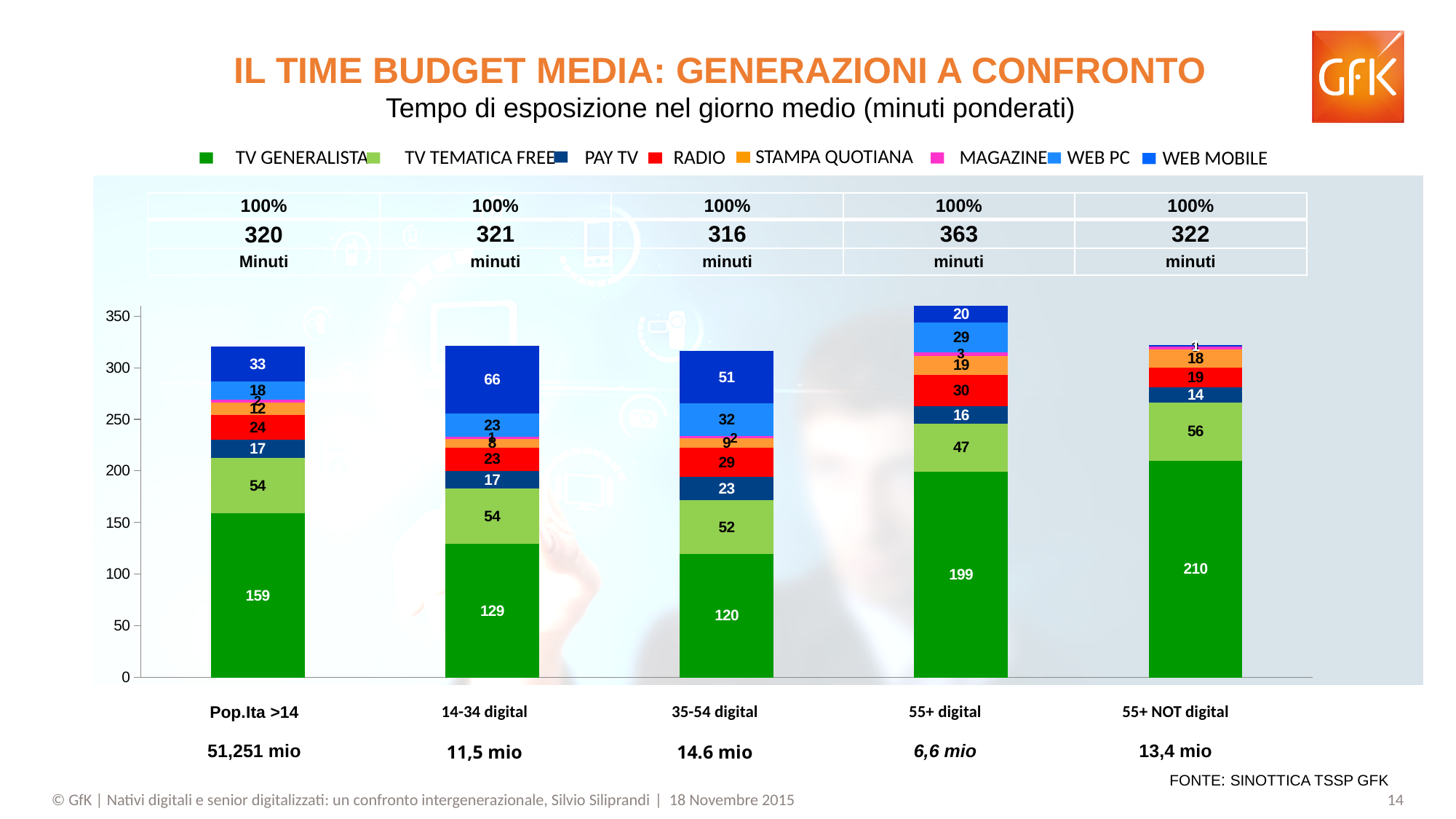
What is the difference between the TV GENERALISTA values for 55+ digital and 14-34 digital? 70 Which has a larger WEB MOBILE value, 35-54 digital or Pop.Ita >14? 35-54 digital What is the TV GENERALISTA value for 55+ NOT digital? 210 What is the WEB MOBILE value for 14-34 digital? 66 How many series does the legend list? 8 What kind of chart is shown on the slide? Stacked bar chart Which category has the highest total minutes? 55+ digital What is the RADIO value for 55+ digital? 30 How many categories (bars) are plotted on the x axis? 5 What is the total minutes shown for the 55+ digital bar? 363 What is the TV TEMATICA FREE value for 35-54 digital? 52 Which category has the lowest total minutes? 35-54 digital